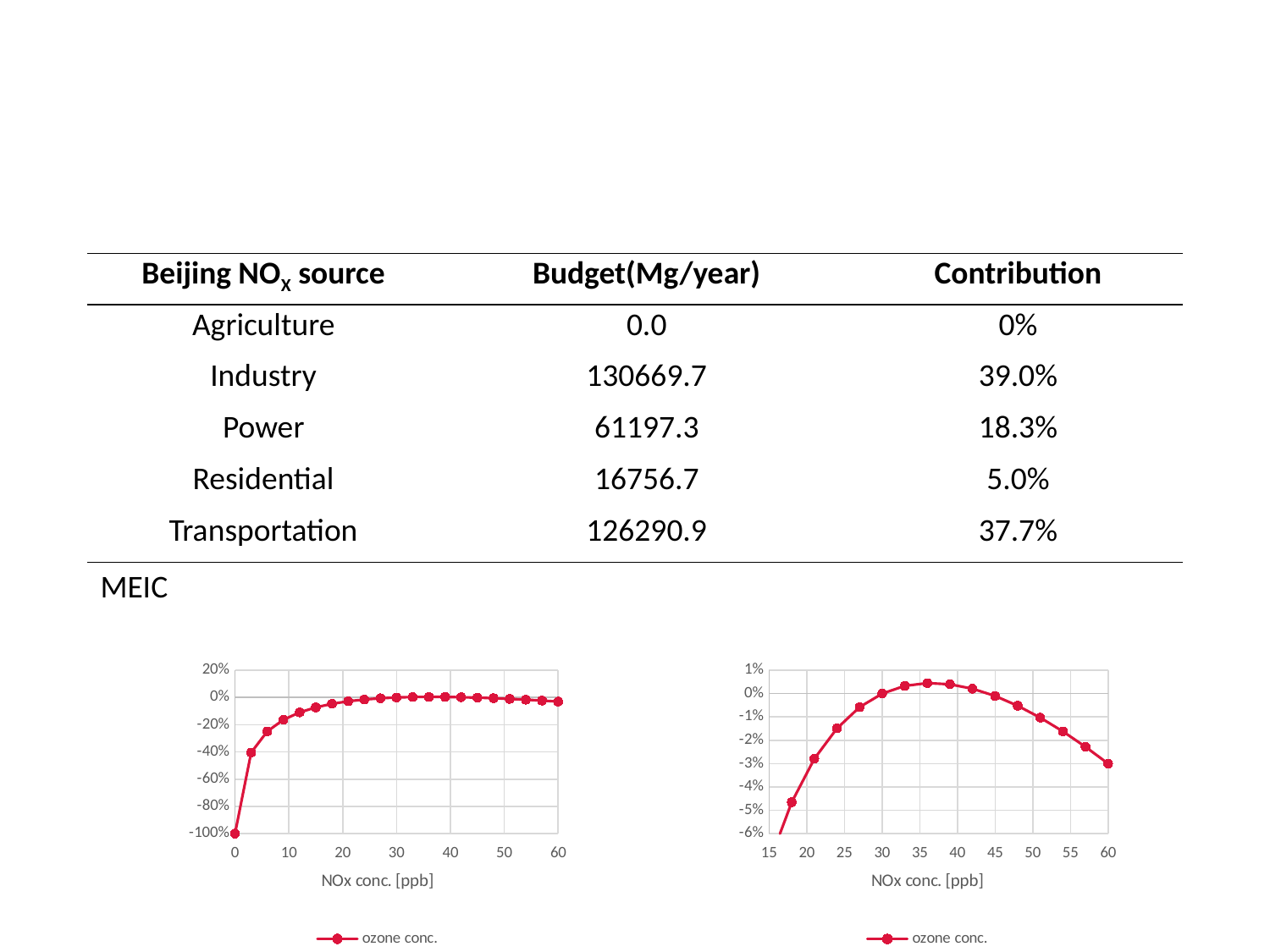
What is the x-axis label of the left chart? NOx conc. [ppb] In the left chart, is the value of ozone conc. at NOx conc. 3 ppb greater or less than -20%? less In the right chart, does the ozone conc. line rise or fall between NOx conc. 40 ppb and 60 ppb? fall How many series does the legend of the right chart list? 1 In the left chart, does the ozone conc. line rise or fall between NOx conc. 0 ppb and 20 ppb? rise What kind of chart is the right chart on the slide? line chart In the left chart, is the value of ozone conc. at NOx conc. 60 ppb greater or less than -20%? greater In the right chart, is the value of ozone conc. at NOx conc. 18 ppb greater or less than -4%? less In the left chart, what is the value of ozone conc. at NOx conc. 0 ppb? -100% What kind of chart is the left chart on the slide? line chart